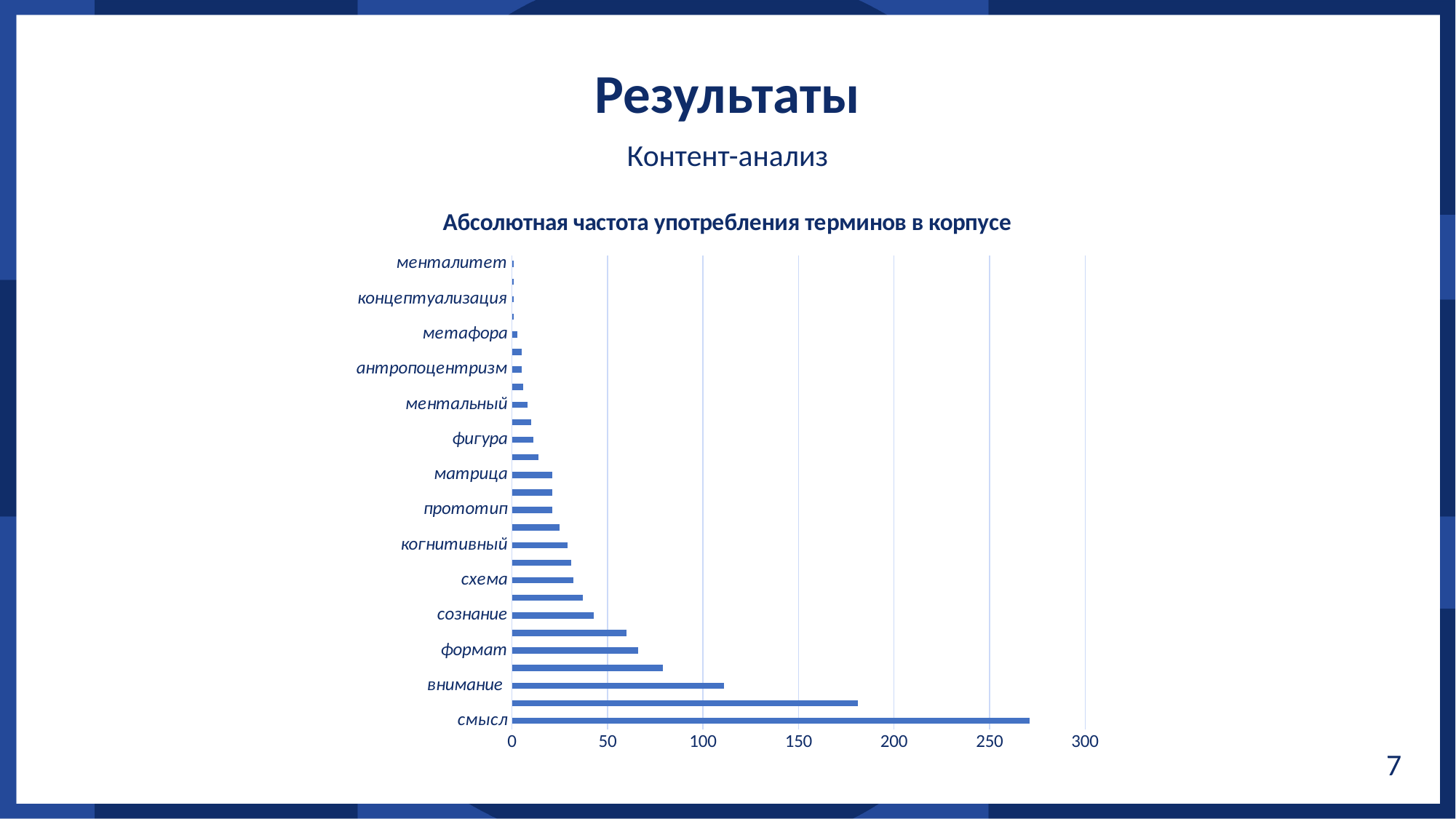
Is the value for сознание greater or less than 50? less Is the value for смысл greater or less than 250? greater Is the value for внимание greater or less than 100? greater What is the largest value shown on the horizontal axis? 300 What is the title of the chart? Абсолютная частота употребления терминов в корпусе Which has a larger value, формат or сознание? формат Which has a larger value, смысл or внимание? смысл Which term has the highest frequency in the chart? смысл What kind of chart is shown on the slide? bar chart